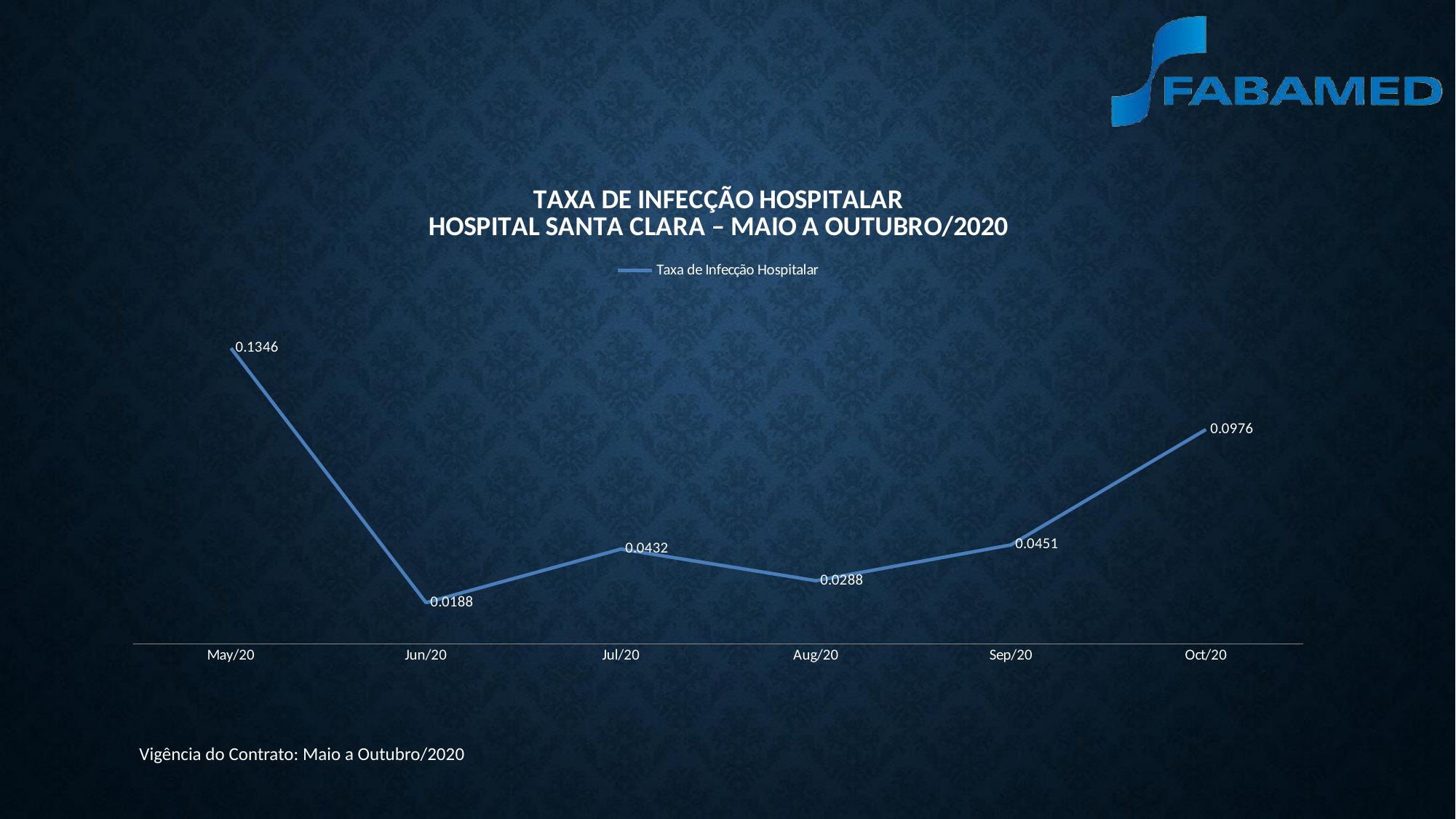
Which month has the highest Taxa de Infecção Hospitalar? May/20 Does the Taxa de Infecção Hospitalar rise or fall from Aug/20 to Oct/20? Rise What kind of chart is shown on the slide? Line chart What is the Taxa de Infecção Hospitalar value for Jun/20? 0.0188 What is the Taxa de Infecção Hospitalar value for May/20? 0.1346 What is the Taxa de Infecção Hospitalar value for Aug/20? 0.0288 How many months are plotted on the chart? 6 What is the difference between the Taxa de Infecção Hospitalar for May/20 and Jun/20? 0.1158 Which month has the lowest Taxa de Infecção Hospitalar? Jun/20 What is the Taxa de Infecção Hospitalar value for Oct/20? 0.0976 Which is larger, the Taxa de Infecção Hospitalar for Jul/20 or for Aug/20? Jul/20 What is the difference between the Taxa de Infecção Hospitalar for Oct/20 and Sep/20? 0.0525